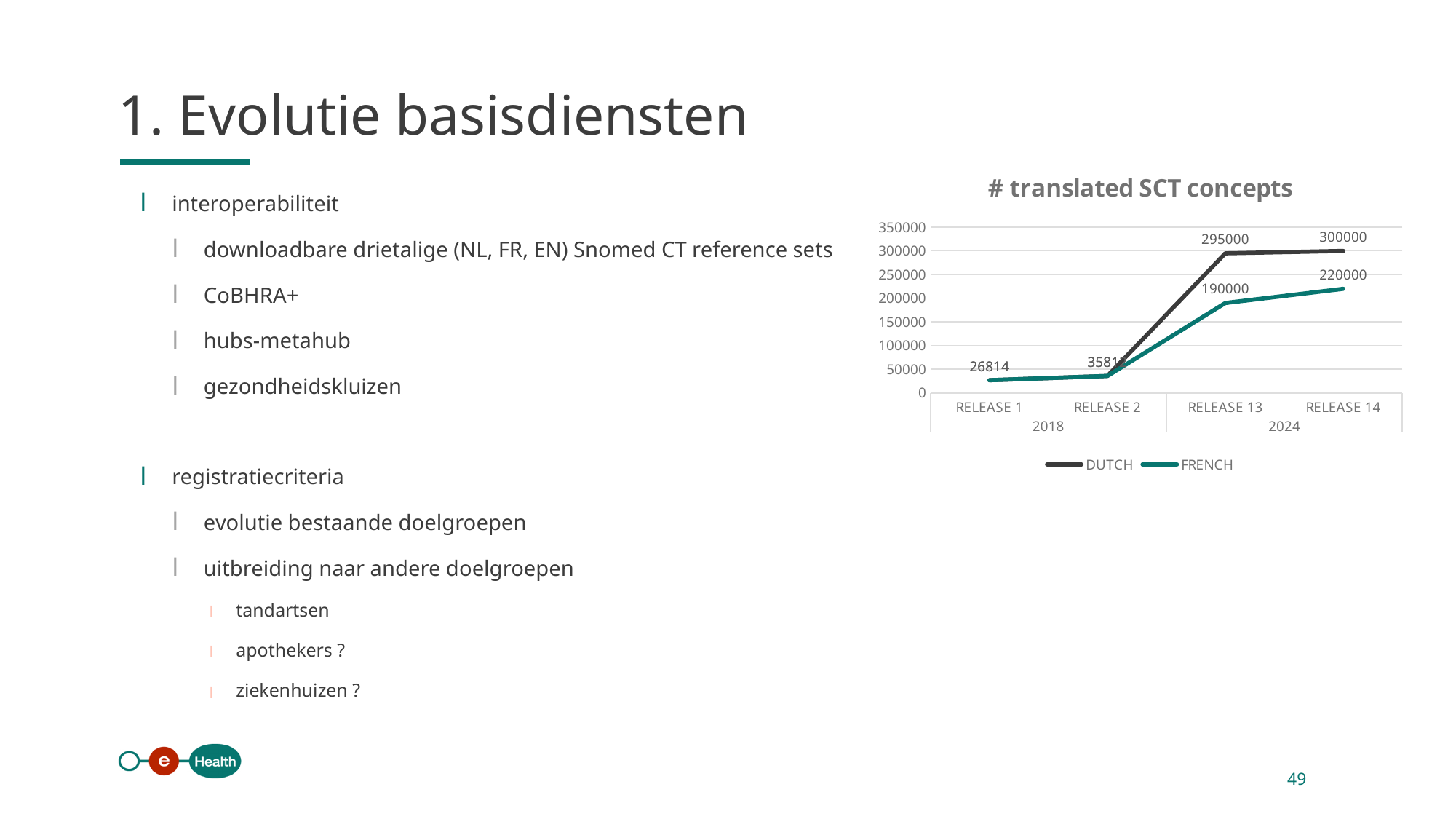
What is the DUTCH value at RELEASE 14? 300000 How many series does the chart legend list? 2 What is the title of the chart? # translated SCT concepts What is the FRENCH value at RELEASE 13? 190000 What is the difference between the DUTCH and FRENCH values at RELEASE 14? 80000 What kind of chart is shown on the slide? line chart What is the FRENCH value at RELEASE 14? 220000 Which series has the higher value at RELEASE 13, DUTCH or FRENCH? DUTCH How many release categories are plotted along the x axis? 4 Is the FRENCH value at RELEASE 1 greater or less than 50000? less Do the values for the DUTCH series rise or fall from RELEASE 1 to RELEASE 14? rise What is the DUTCH value at RELEASE 13? 295000